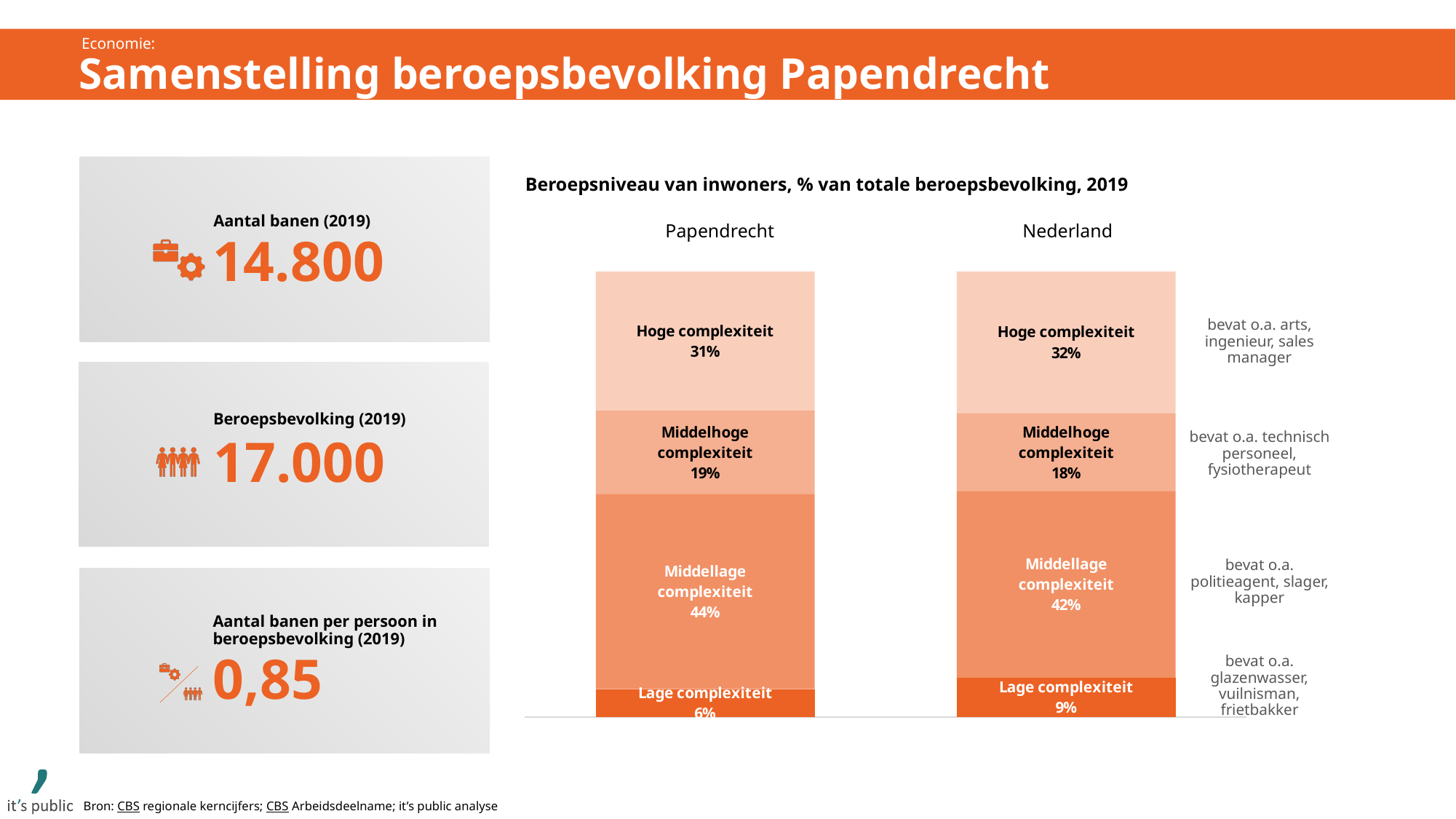
What percentage of the Papendrecht workforce is in 'Hoge complexiteit' in the chart 'Beroepsniveau van inwoners'? 31% What kind of chart is shown on the right side of the slide? Stacked bar chart How many bars are shown in the chart 'Beroepsniveau van inwoners'? 2 What is the title of the chart on the slide? Beroepsniveau van inwoners, % van totale beroepsbevolking, 2019 Which segment is the smallest in the Nederland bar? Lage complexiteit What percentage of the Nederland workforce is in 'Lage complexiteit' in the chart 'Beroepsniveau van inwoners'? 9% What is the value for 'Middellage complexiteit' for Papendrecht in the chart? 44% What is the difference between the 'Lage complexiteit' share for Nederland and for Papendrecht? 3% Which has a larger 'Middellage complexiteit' share, Papendrecht or Nederland? Papendrecht How many segments does each stacked bar in the chart contain? 4 Which segment is the largest in the Papendrecht bar? Middellage complexiteit What is the value for 'Middelhoge complexiteit' for Nederland in the chart? 18%